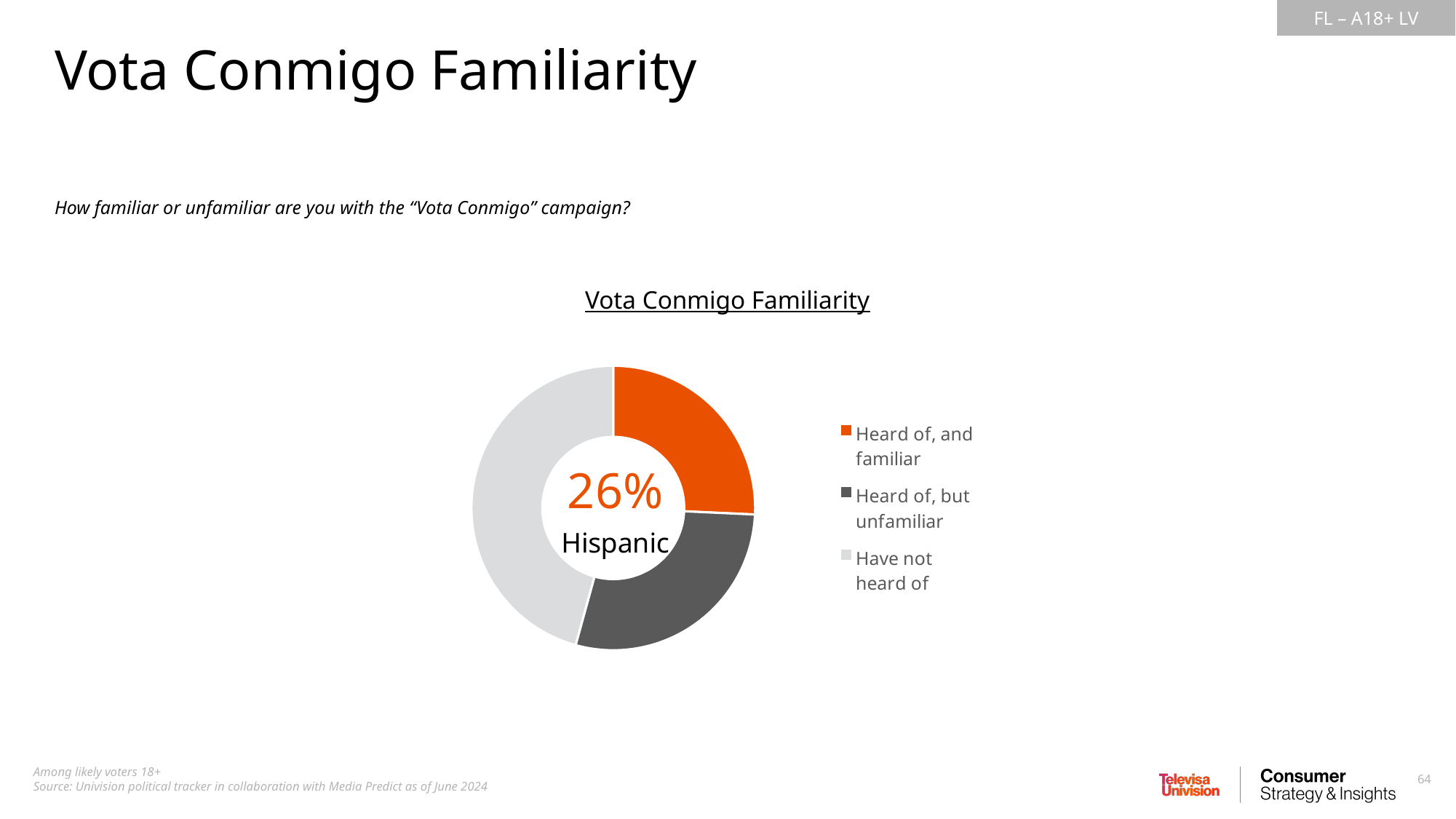
What is the title of the chart on the slide? Vota Conmigo Familiarity Is the share for 'Have not heard of' in the Vota Conmigo Familiarity chart greater or less than 26%? greater How many slices does the Vota Conmigo Familiarity donut chart have? 3 Which slice is larger in the Vota Conmigo Familiarity chart: 'Have not heard of' or 'Heard of, but unfamiliar'? Have not heard of Which group is named in the centre of the donut chart? Hispanic Which slice is larger in the Vota Conmigo Familiarity chart: 'Have not heard of' or 'Heard of, and familiar'? Have not heard of What percentage is printed in the centre of the Vota Conmigo Familiarity donut chart? 26% What share of Hispanic likely voters have heard of and are familiar with the Vota Conmigo campaign, according to the chart? 26% Which category takes the largest share of the Vota Conmigo Familiarity chart? Have not heard of What kind of chart is shown on the slide? Pie chart (donut) How many categories does the legend of the Vota Conmigo Familiarity chart list? 3